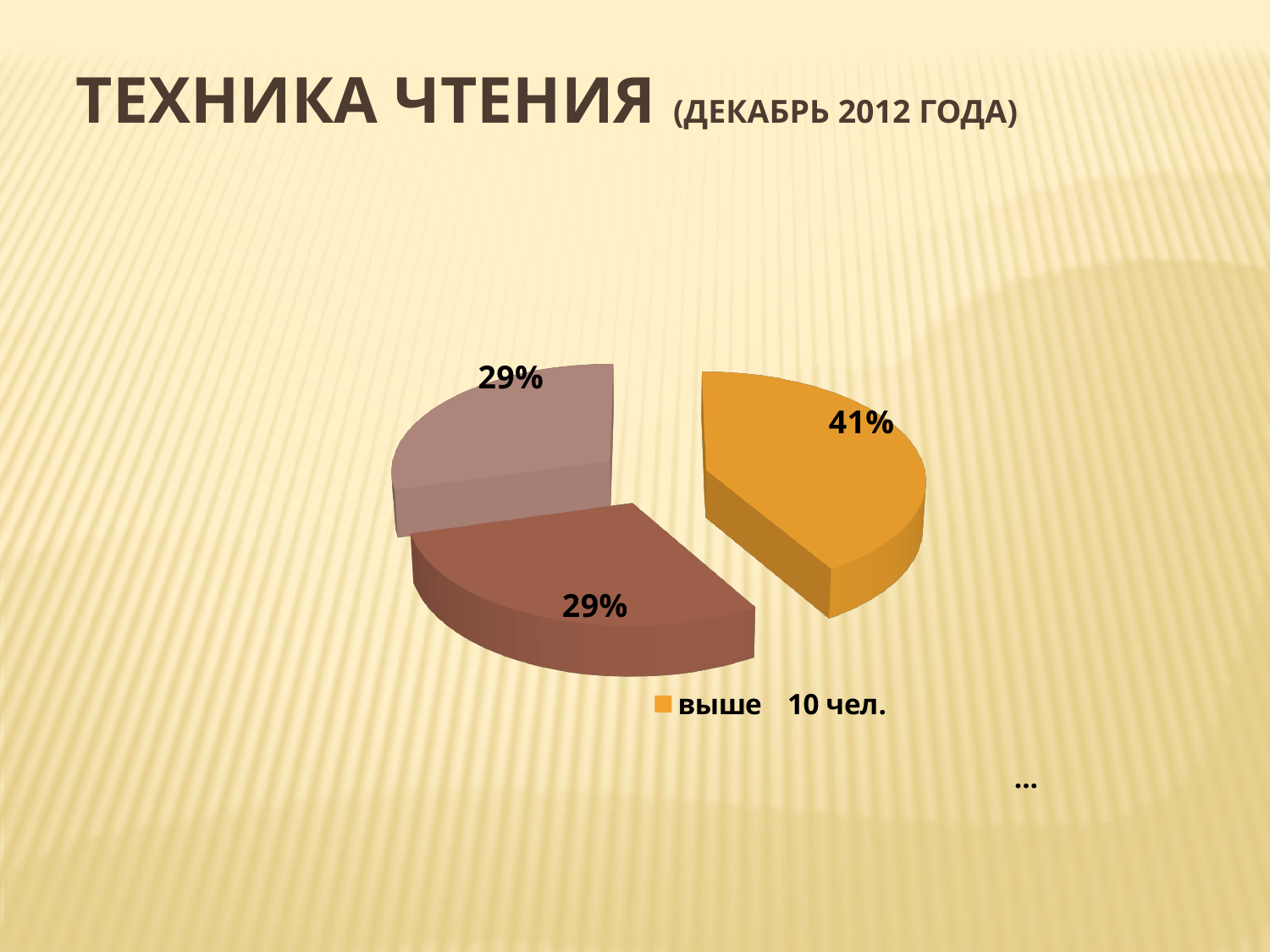
Which is larger, the orange slice or the brown slice? the orange slice What colour is the "выше" slice in the pie chart? orange How many slices does the pie chart have? 3 What percentage is shown on the mauve slice at the top left of the pie? 29% What percentage is shown on the brown slice at the bottom of the pie? 29% Is the share of the "выше" slice greater or less than 50%? less What is the difference in percentage points between the "выше" slice and the brown slice? 12 What kind of chart is shown on the slide? pie chart What is the title of the slide containing the chart? ТЕХНИКА ЧТЕНИЯ (ДЕКАБРЬ 2012 ГОДА) Are the brown slice and the mauve slice equal in size? yes, both 29% Which slice of the pie is the largest? выше (41%) What share of the pie does the "выше" slice represent? 41%